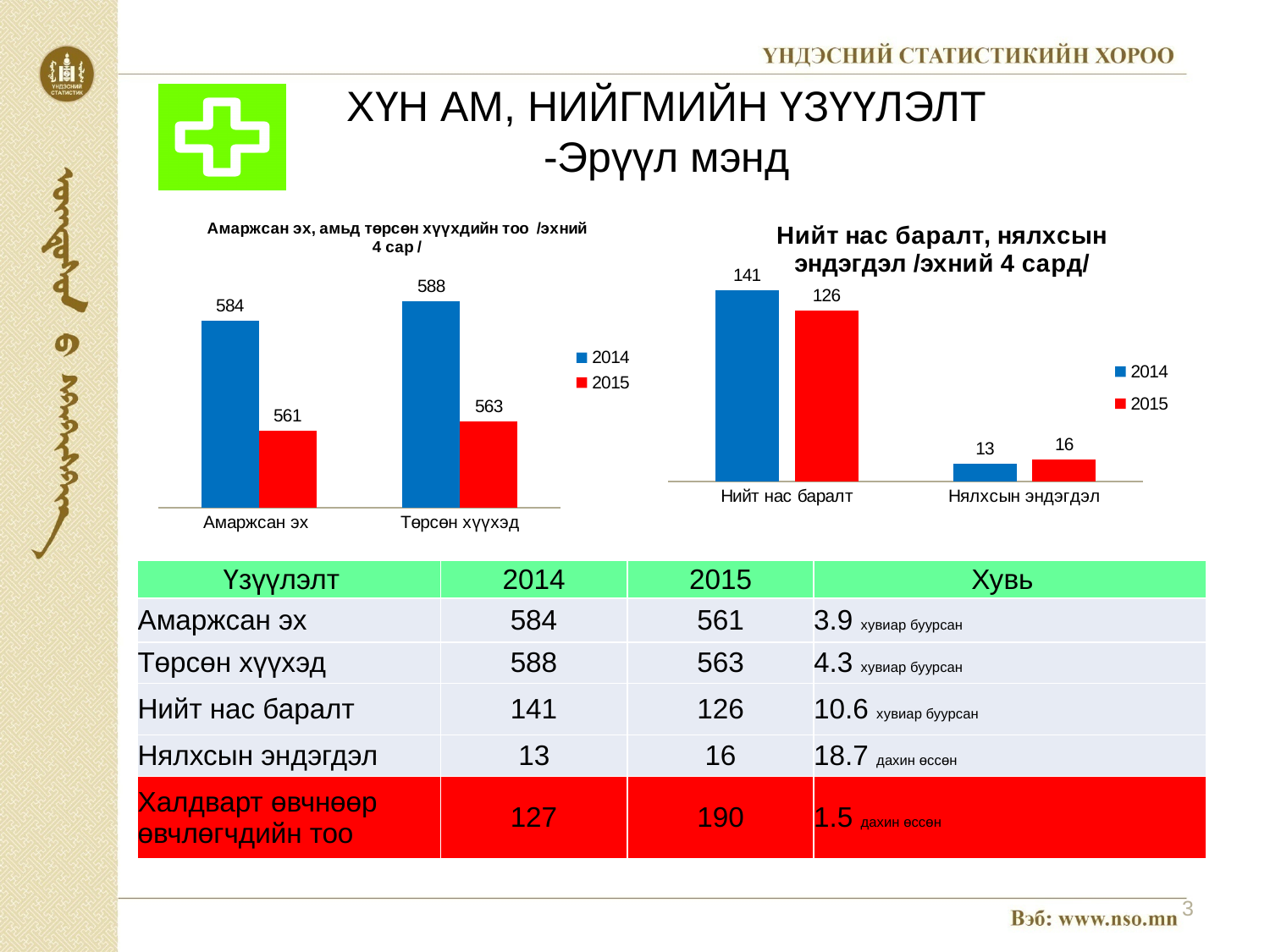
In the left chart (Амаржсан эх, амьд төрсөн хүүхдийн тоо), how many series does the legend list? 2 In the left chart (Амаржсан эх, амьд төрсөн хүүхдийн тоо), which series has the higher value for Төрсөн хүүхэд, 2014 or 2015? 2014 In the left chart (Амаржсан эх, амьд төрсөн хүүхдийн тоо), what is the difference between the 2014 and 2015 values for Амаржсан эх? 23 In the right chart (Нийт нас баралт, нялхсын эндэгдэл), what is the difference between the 2014 and 2015 values for Нийт нас баралт? 15 In the right chart (Нийт нас баралт, нялхсын эндэгдэл), how many categories are shown on the x axis? 2 In the right chart (Нийт нас баралт, нялхсын эндэгдэл), what is the 2014 value for Нийт нас баралт? 141 In the left chart (Амаржсан эх, амьд төрсөн хүүхдийн тоо), what is the 2014 value for Амаржсан эх? 584 In the right chart (Нийт нас баралт, нялхсын эндэгдэл), what is the 2015 value for Нялхсын эндэгдэл? 16 In the right chart (Нийт нас баралт, нялхсын эндэгдэл), which category has the lowest value across both series? Нялхсын эндэгдэл In the right chart (Нийт нас баралт, нялхсын эндэгдэл), which series has the higher value for Нялхсын эндэгдэл, 2014 or 2015? 2015 In the left chart (Амаржсан эх, амьд төрсөн хүүхдийн тоо), what is the 2015 value for Төрсөн хүүхэд? 563 What type of chart is the left chart (Амаржсан эх, амьд төрсөн хүүхдийн тоо)? Bar chart